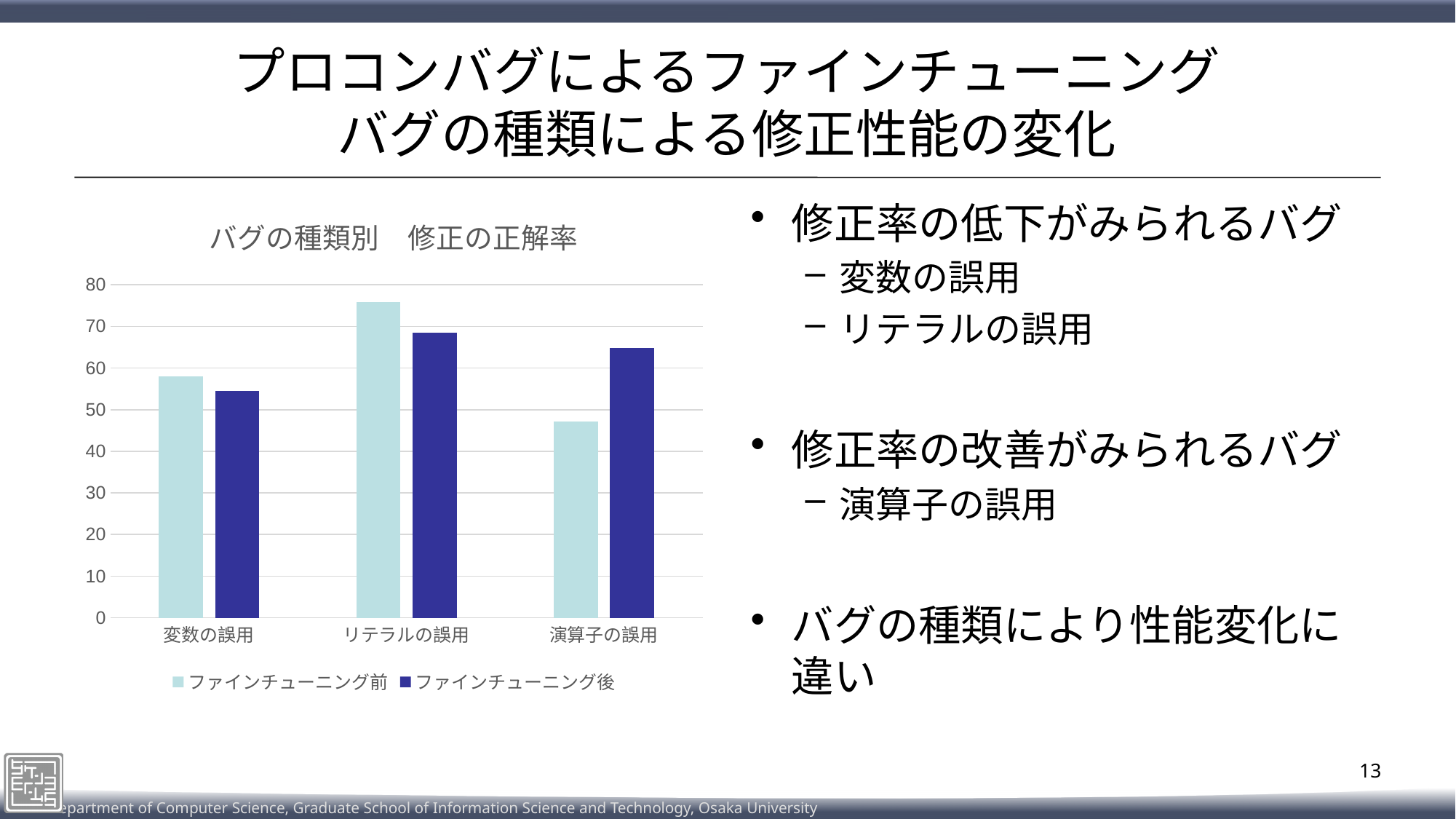
What kind of chart is shown on the slide? bar chart Which category has the lowest ファインチューニング前 value? 演算子の誤用 Is the ファインチューニング後 value for 変数の誤用 greater or less than 60? less For リテラルの誤用, which is larger: ファインチューニング前 or ファインチューニング後? ファインチューニング前 Which category has the lowest ファインチューニング後 value? 変数の誤用 How many bug-type categories are shown on the x axis of the chart? 3 Is the ファインチューニング前 value for リテラルの誤用 greater or less than 70? greater What is the title of the chart? バグの種類別 修正の正解率 Which category has the highest ファインチューニング前 value? リテラルの誤用 For 演算子の誤用, which is larger: ファインチューニング前 or ファインチューニング後? ファインチューニング後 How many series does the chart legend list? 2 Is the ファインチューニング前 value for 演算子の誤用 greater or less than 50? less